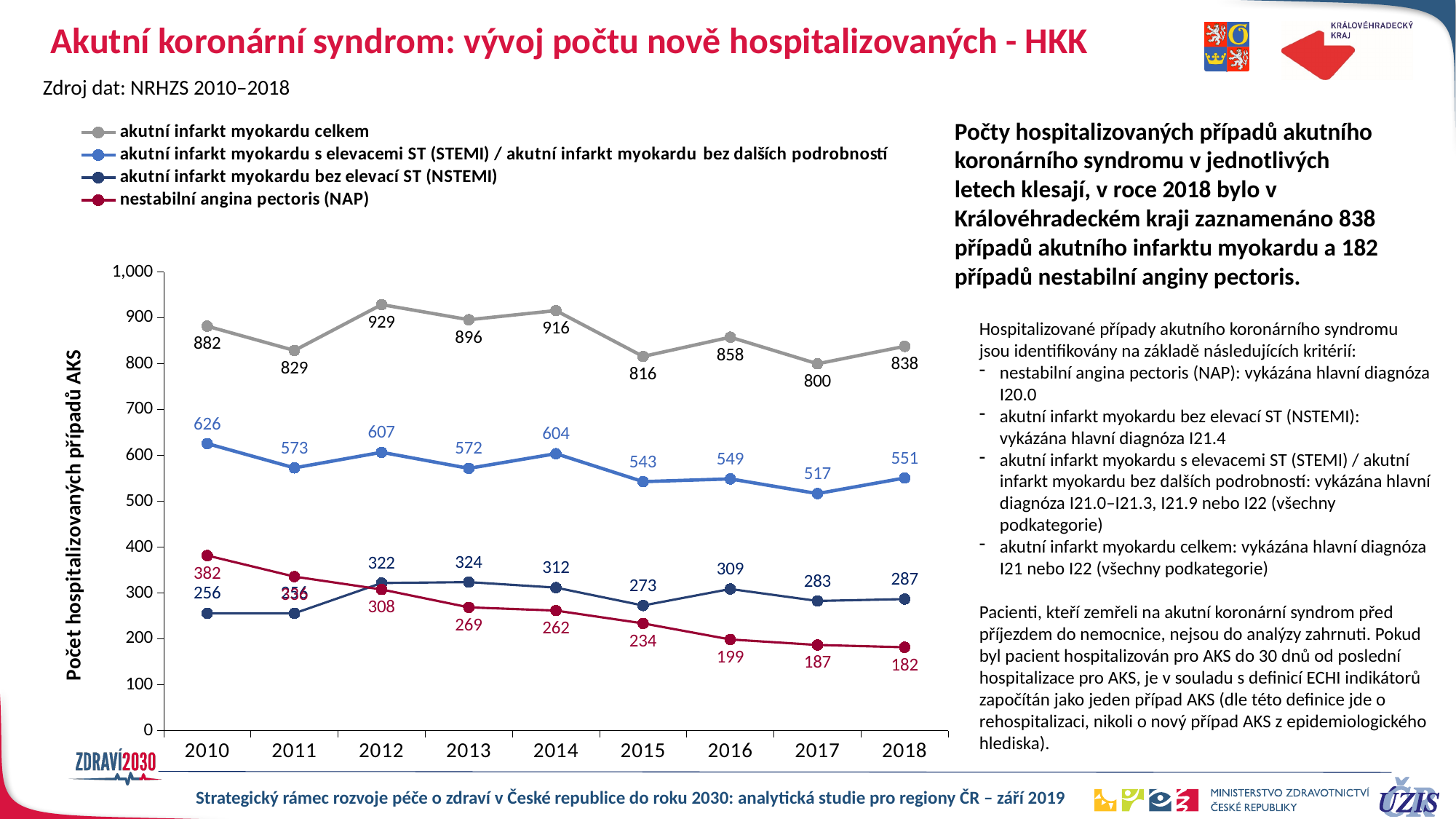
Which year has the larger value for the STEMI series: 2010 or 2014? 2010 How many series does the legend list? 4 What is the difference between the 2010 and 2018 values for 'nestabilní angina pectoris (NAP)'? 200 What is the value for 'akutní infarkt myokardu celkem' in 2018? 838 What is the difference between the 2012 and 2017 values for 'akutní infarkt myokardu celkem'? 129 Is the value for the STEMI series in 2017 greater or less than 600? less In which year is the value for 'akutní infarkt myokardu celkem' lowest? 2017 What is the value for 'nestabilní angina pectoris (NAP)' in 2010? 382 In which year is the value for 'akutní infarkt myokardu celkem' highest? 2012 What is the value for 'akutní infarkt myokardu bez elevací ST (NSTEMI)' in 2013? 324 Do the values for 'nestabilní angina pectoris (NAP)' rise or fall from 2010 to 2018? fall How many years are shown on the x axis of the chart? 9